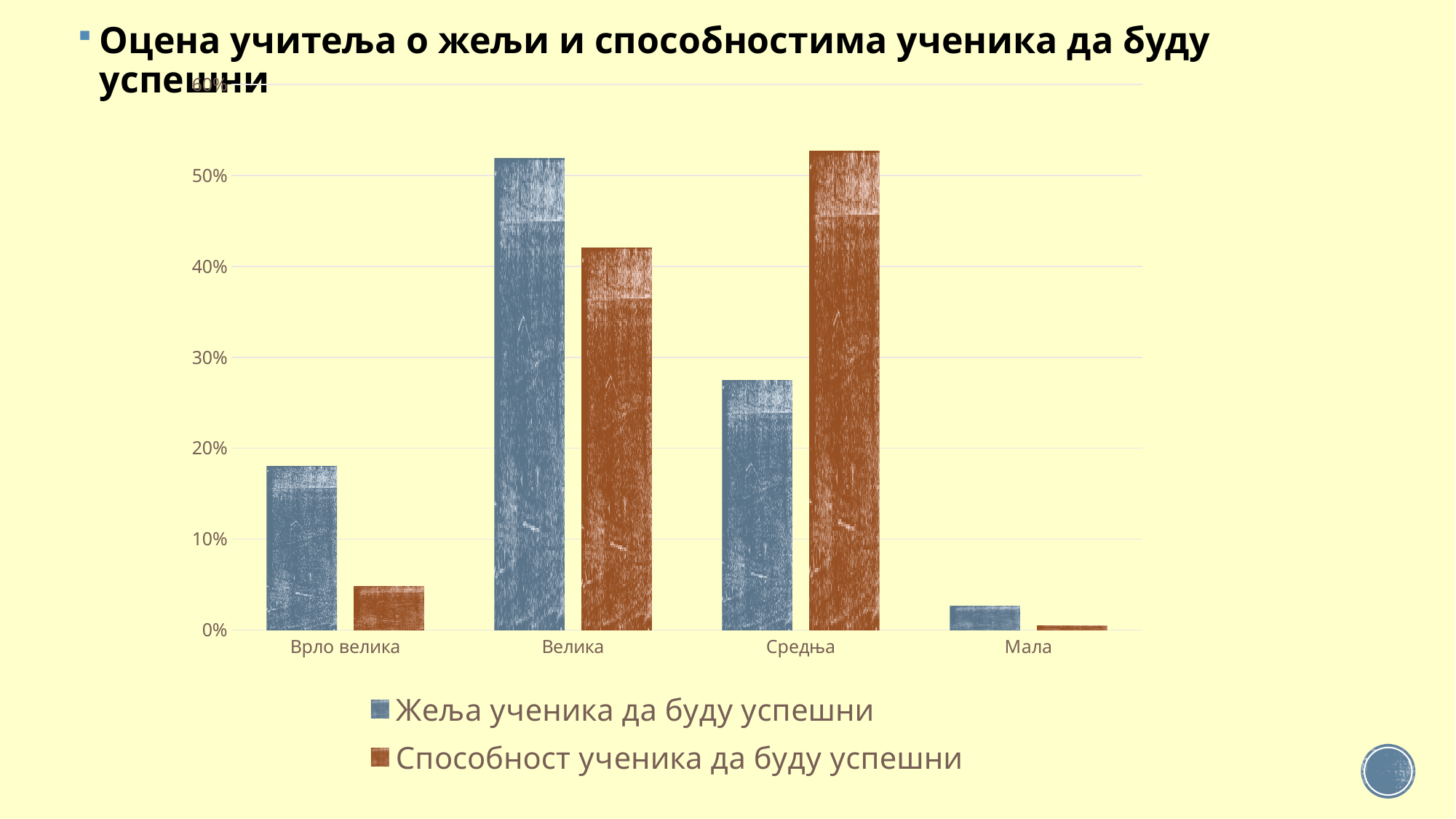
Is the value for 'Велика' in the series 'Способност ученика да буду успешни' greater or less than 30%? greater How many categories are shown on the x axis of the chart? 4 Is the value for 'Врло велика' in the series 'Жеља ученика да буду успешни' greater or less than 20%? less Which category has the lowest value for the series 'Жеља ученика да буду успешни'? Мала Is the value for 'Средња' in the series 'Способност ученика да буду успешни' greater or less than 50%? greater What colour are the bars for the series 'Способност ученика да буду успешни'? brown For the category 'Велика', which series has the larger value? Жеља ученика да буду успешни Which category has the highest value for the series 'Жеља ученика да буду успешни'? Велика What kind of chart is shown on the slide? bar chart For the category 'Средња', which series has the larger value? Способност ученика да буду успешни Which category has the highest value for the series 'Способност ученика да буду успешни'? Средња How many series does the legend list? 2